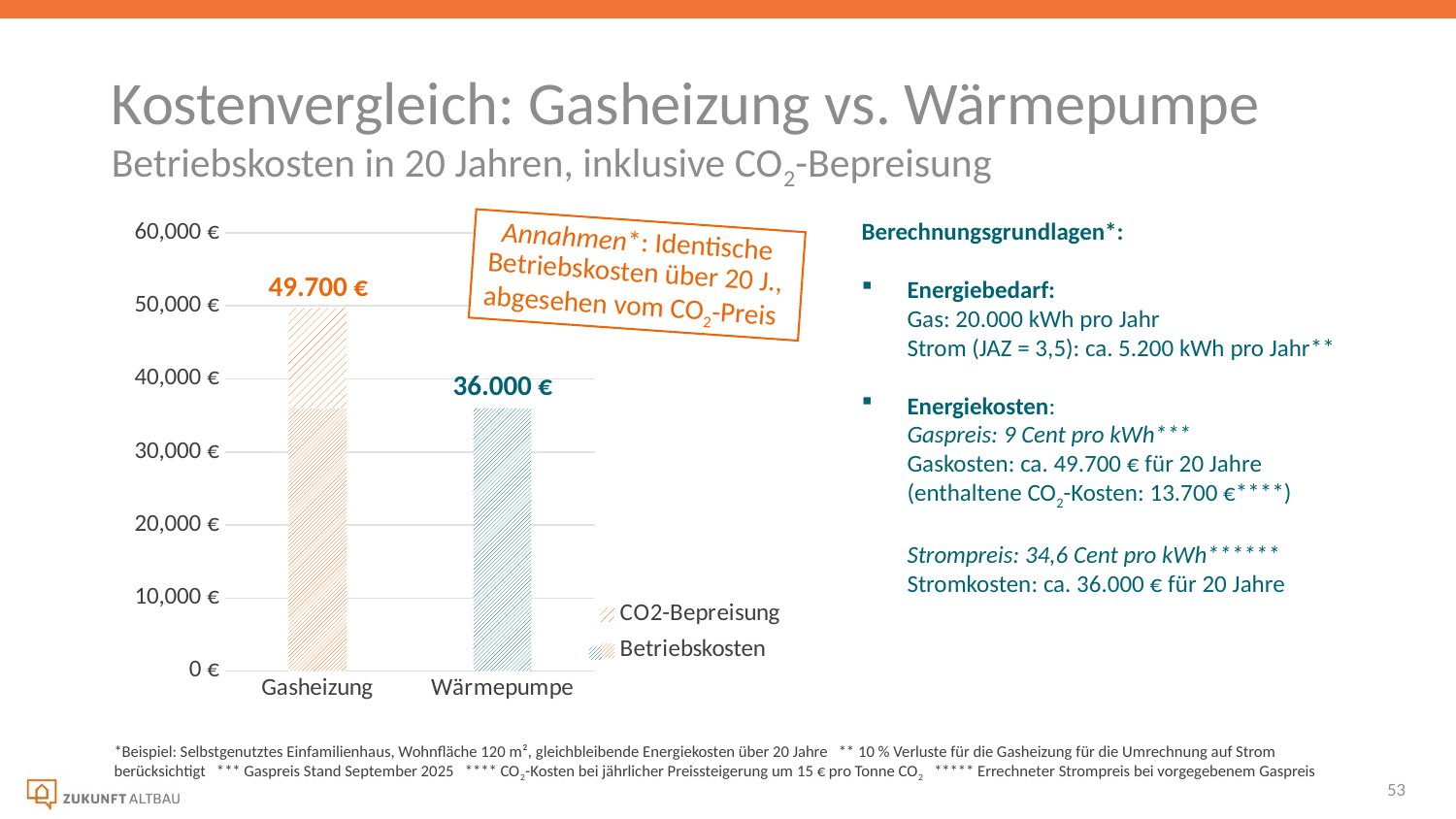
Which is larger, the value for Gasheizung or the value for Wärmepumpe? Gasheizung How many categories are shown on the x axis of the chart? 2 What is the total value shown for Gasheizung? 49.700 € What is the difference between the Gasheizung total and the Wärmepumpe total? 13.700 € Which category has the higher total cost? Gasheizung What is the value shown for Wärmepumpe? 36.000 € What are the two entries in the chart legend? CO2-Bepreisung and Betriebskosten What kind of chart is shown on the slide? bar chart Which category has the lower total cost? Wärmepumpe How many series does the chart legend list? 2 Is the value for Wärmepumpe greater or less than 40,000 €? less Is the total value for Gasheizung greater or less than 40,000 €? greater